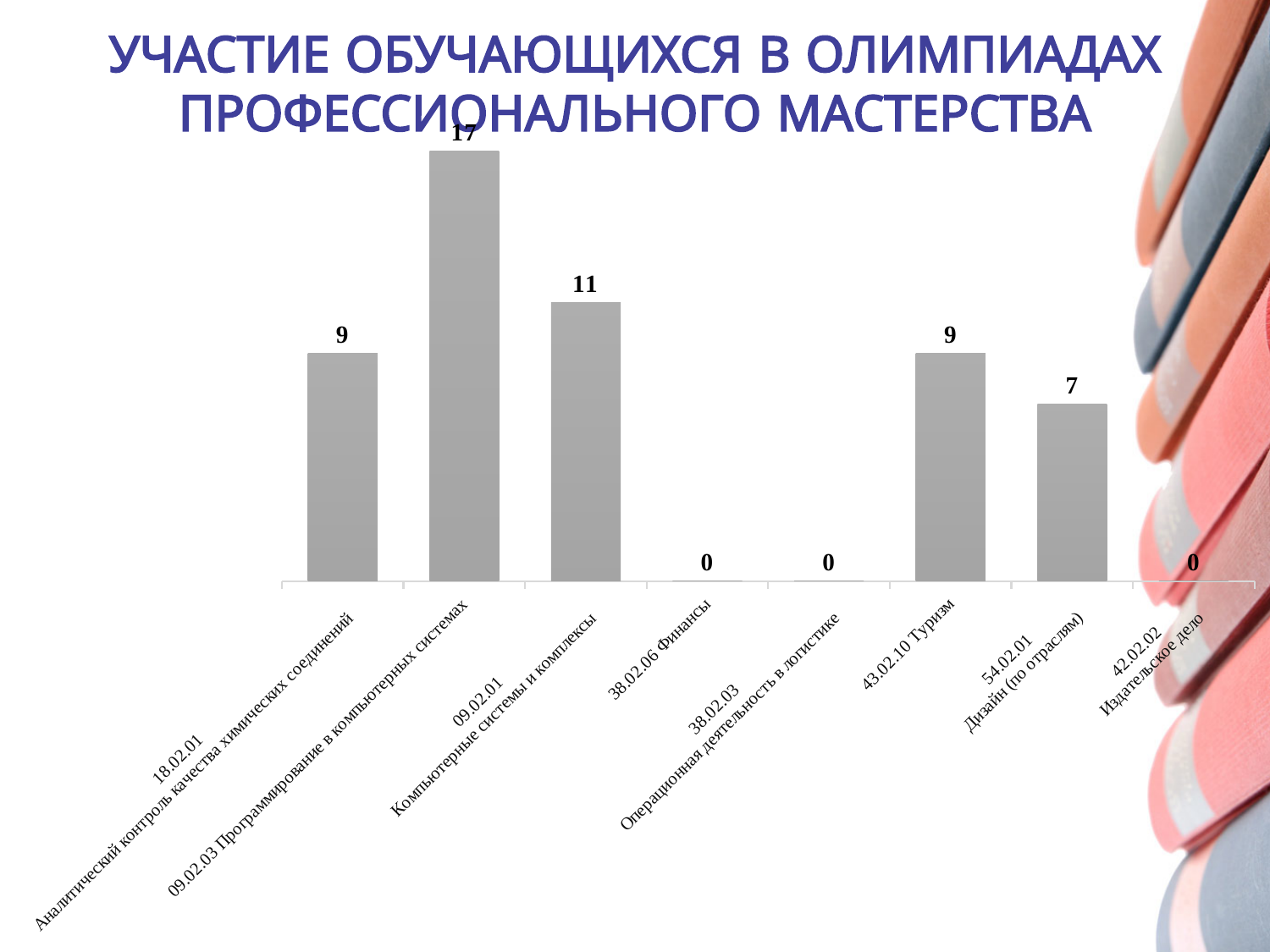
What value is shown for 38.02.06 Финансы? 0 What is the difference between the values for 09.02.03 Программирование в компьютерных системах and 09.02.01 Компьютерные системы и комплексы? 6 What value is shown for 43.02.10 Туризм? 9 What is the difference between the values for 18.02.01 Аналитический контроль качества химических соединений and 54.02.01 Дизайн (по отраслям)? 2 What is the title of the slide? Участие обучающихся в олимпиадах профессионального мастерства What kind of chart is shown on the slide? Bar chart What value is shown for 54.02.01 Дизайн (по отраслям)? 7 What value is shown for 09.02.03 Программирование в компьютерных системах? 17 Which category has the highest value? 09.02.03 Программирование в компьютерных системах How many categories are shown on the x axis? 8 Which is larger: the value for 09.02.01 Компьютерные системы и комплексы or the value for 43.02.10 Туризм? 09.02.01 Компьютерные системы и комплексы How many categories have a value of 0? 3